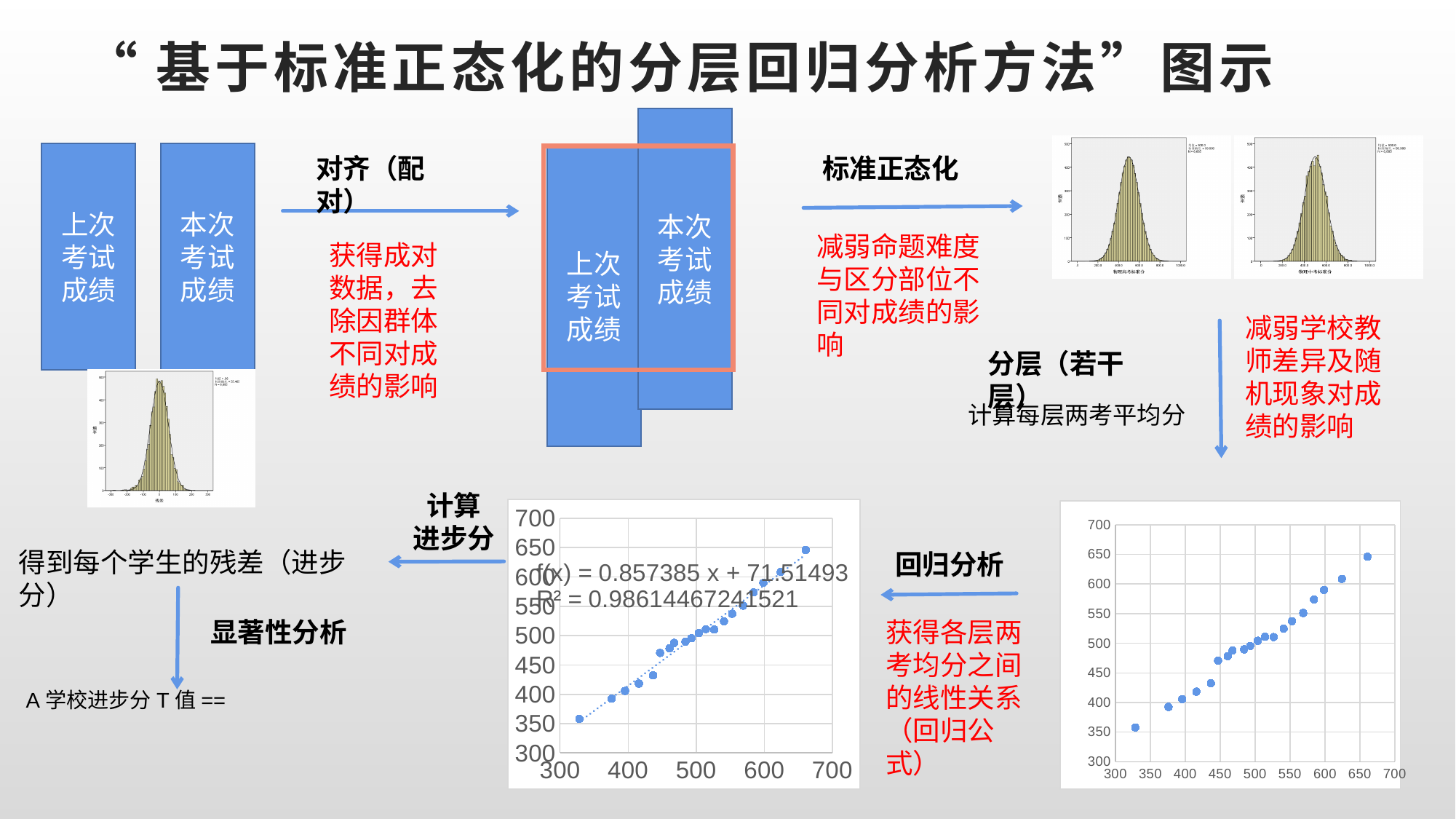
In the bottom-middle chart, what is the intercept of the fitted line shown in the equation f(x)? 71.51493 What is the highest tick value on the y axis of the bottom-right chart? 700 What is the lowest tick value on the x axis of the bottom-middle chart? 300 In the bottom-right chart, is the y value of the highest point greater or less than 600? greater In the bottom-middle chart, what is the slope of the fitted line shown in the equation f(x)? 0.857385 In the bottom-middle chart, do the plotted points rise or fall as x increases? rise What kind of chart is the bottom-middle chart with the fitted equation? scatter chart In the bottom-right chart, is the x value of the leftmost point greater or less than 350? less In the bottom-right chart, do the plotted points rise or fall as x increases? rise In the bottom-middle chart, is the y value of the lowest point greater or less than 400? less What kind of chart is the bottom-right chart? scatter chart In the bottom-middle chart, what R² value is printed? 0.98614467241521